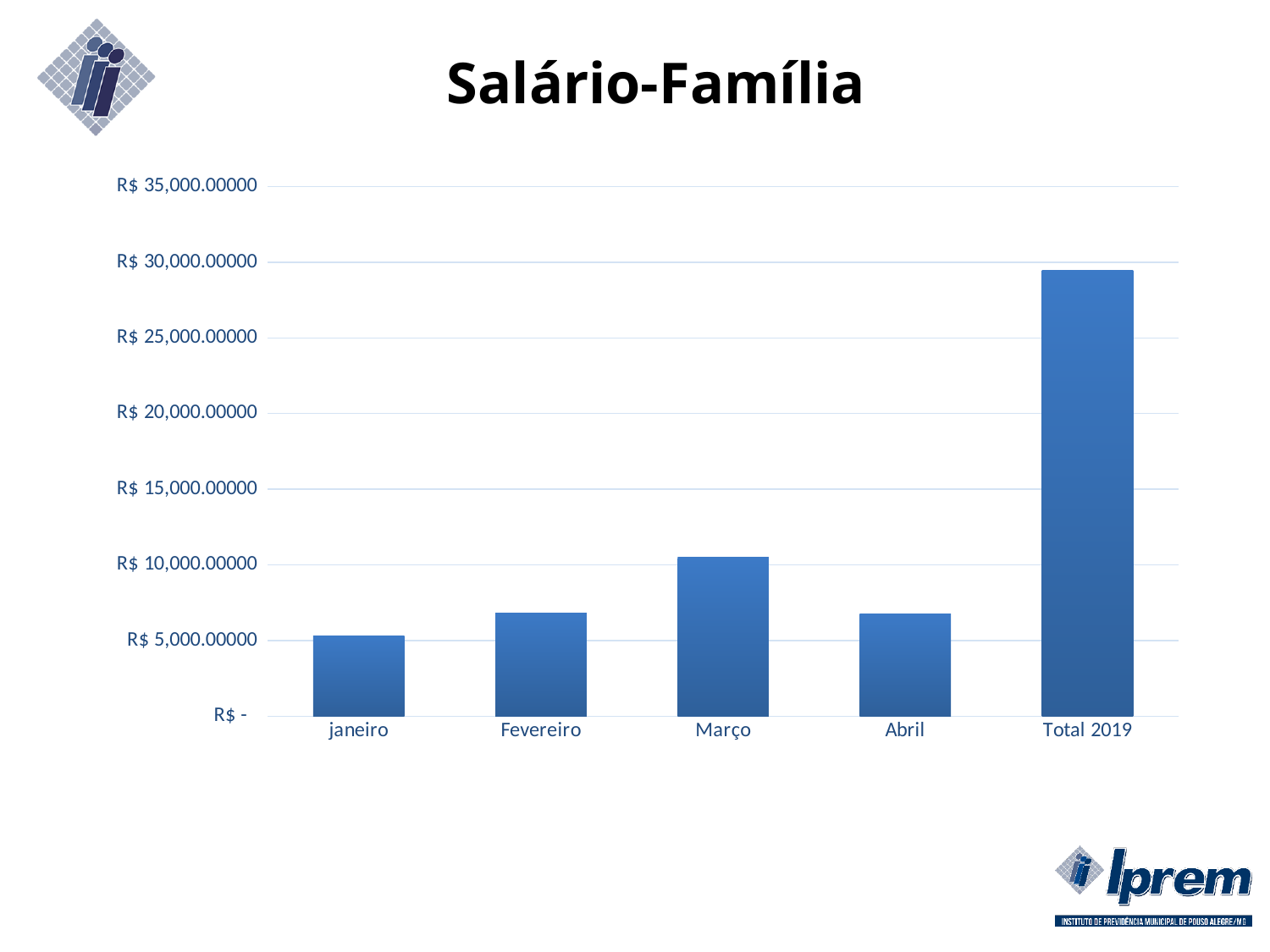
How many categories are shown on the x axis of the chart? 5 Which category has the lowest bar in the chart? janeiro Which category has the highest bar in the chart? Total 2019 Is the value for janeiro greater or less than R$ 10,000.00000? less Which month has the highest bar among janeiro, Fevereiro, Março and Abril? Março What kind of chart is shown on the slide? bar chart Is the value for Total 2019 greater or less than R$ 30,000.00000? less Which is larger, the value for janeiro or the value for Fevereiro? Fevereiro What is the title of the slide containing the chart? Salário-Família Is the value for Março greater or less than R$ 10,000.00000? greater Which is larger, the value for Março or the value for Abril? Março